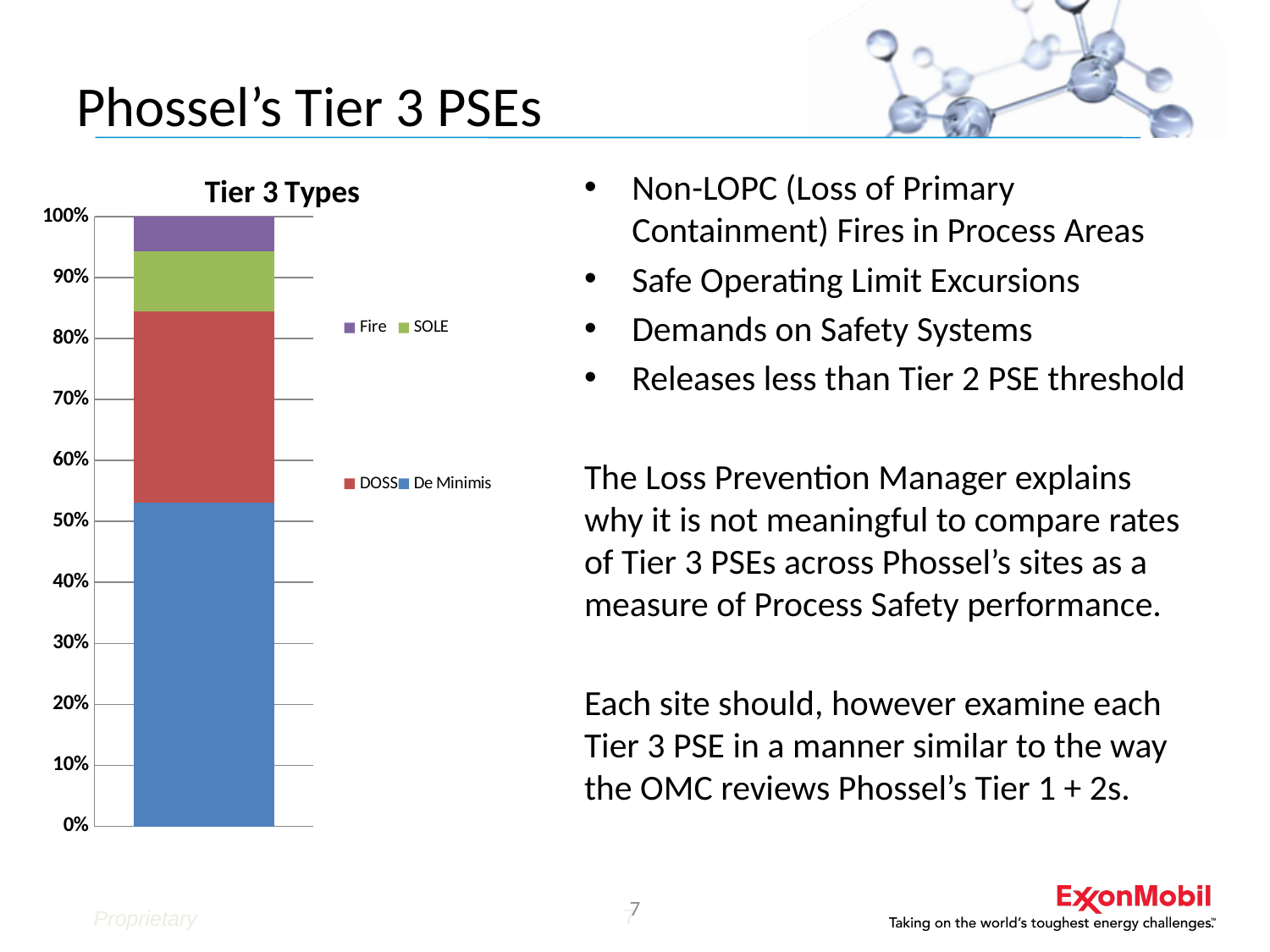
Which segment is larger in the stacked bar, DOSS or SOLE? DOSS Which series takes up the smallest portion of the stacked bar? Fire What is the title of the chart? Tier 3 Types Which series takes up the largest portion of the stacked bar? De Minimis What is the total height of the stacked bar on the percentage axis? 100% How many series does the chart's legend list? 4 Which series are listed in the chart's legend? Fire, SOLE, DOSS, De Minimis What kind of chart is shown on the slide? Stacked bar chart How many bars are plotted in the chart? 1 Is the share for De Minimis greater or less than 60%? less Which segment is larger in the stacked bar, De Minimis or DOSS? De Minimis Is the share for Fire greater or less than 10%? less